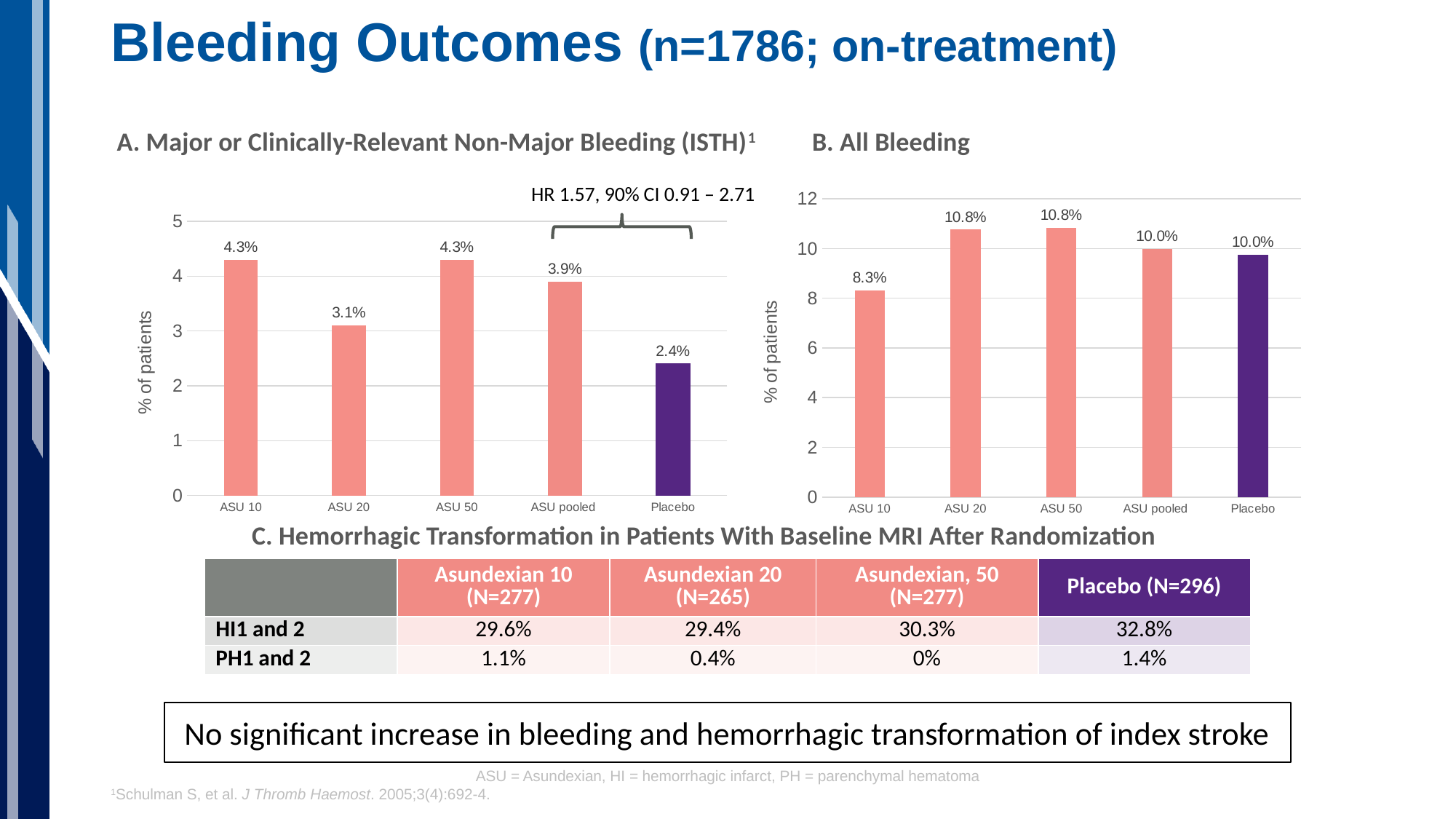
In chart B (All Bleeding), is the value for ASU 20 larger or smaller than the value for ASU 10? larger In chart B (All Bleeding), what is the value for ASU pooled? 10.0% In chart A (Major or Clinically-Relevant Non-Major Bleeding), what hazard ratio is annotated above the ASU pooled and Placebo bars? HR 1.57, 90% CI 0.91 – 2.71 In chart B (All Bleeding), which category has the lowest value? ASU 10 What type of chart is chart B (All Bleeding)? bar chart In chart B (All Bleeding), what is the value for ASU 10? 8.3% In chart B (All Bleeding), what is the difference between ASU 50 and ASU 10? 2.5% In chart A (Major or Clinically-Relevant Non-Major Bleeding), how many categories are shown on the x axis? 5 In chart A (Major or Clinically-Relevant Non-Major Bleeding), what is the value for Placebo? 2.4% In chart A (Major or Clinically-Relevant Non-Major Bleeding), what is the difference between ASU pooled and Placebo? 1.5% In chart A (Major or Clinically-Relevant Non-Major Bleeding), which category has the lowest value? Placebo In chart A (Major or Clinically-Relevant Non-Major Bleeding), what is the value for ASU 20? 3.1%